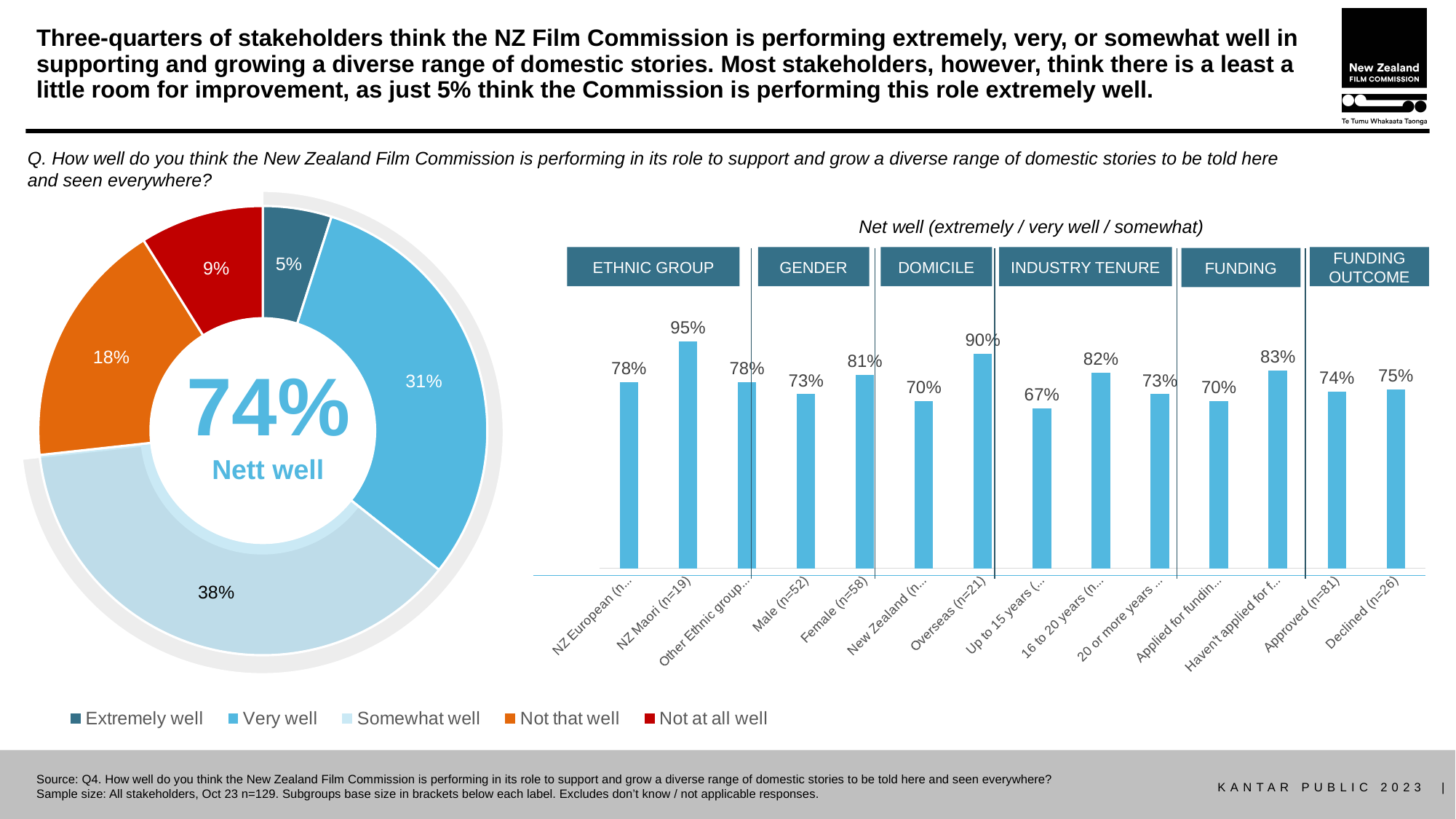
What type of chart is shown on the right of the slide? Bar chart In the donut chart on the left, which response category has the largest share? Somewhat well What is the 'Nett well' figure shown in the centre of the donut chart? 74% In the 'Net well' bar chart on the right, which subgroup has the lowest value? Up to 15 years In the donut chart on the left, which response category has the smallest share? Extremely well How many response categories does the legend of the donut chart list? 5 In the 'Net well' bar chart on the right, what is the value for Female (n=58)? 81% In the donut chart on the left, what share of stakeholders said the Commission is performing 'Very well'? 31% In the 'Net well' bar chart on the right, which is larger: the value for Approved (n=81) or Declined (n=26)? Declined (n=26) In the donut chart on the left, what is the difference between the 'Somewhat well' share and the 'Not at all well' share? 29 percentage points In the donut chart on the left, what share of stakeholders said 'Not that well'? 18% In the 'Net well' bar chart on the right, what is the value for NZ Maori (n=19)? 95%